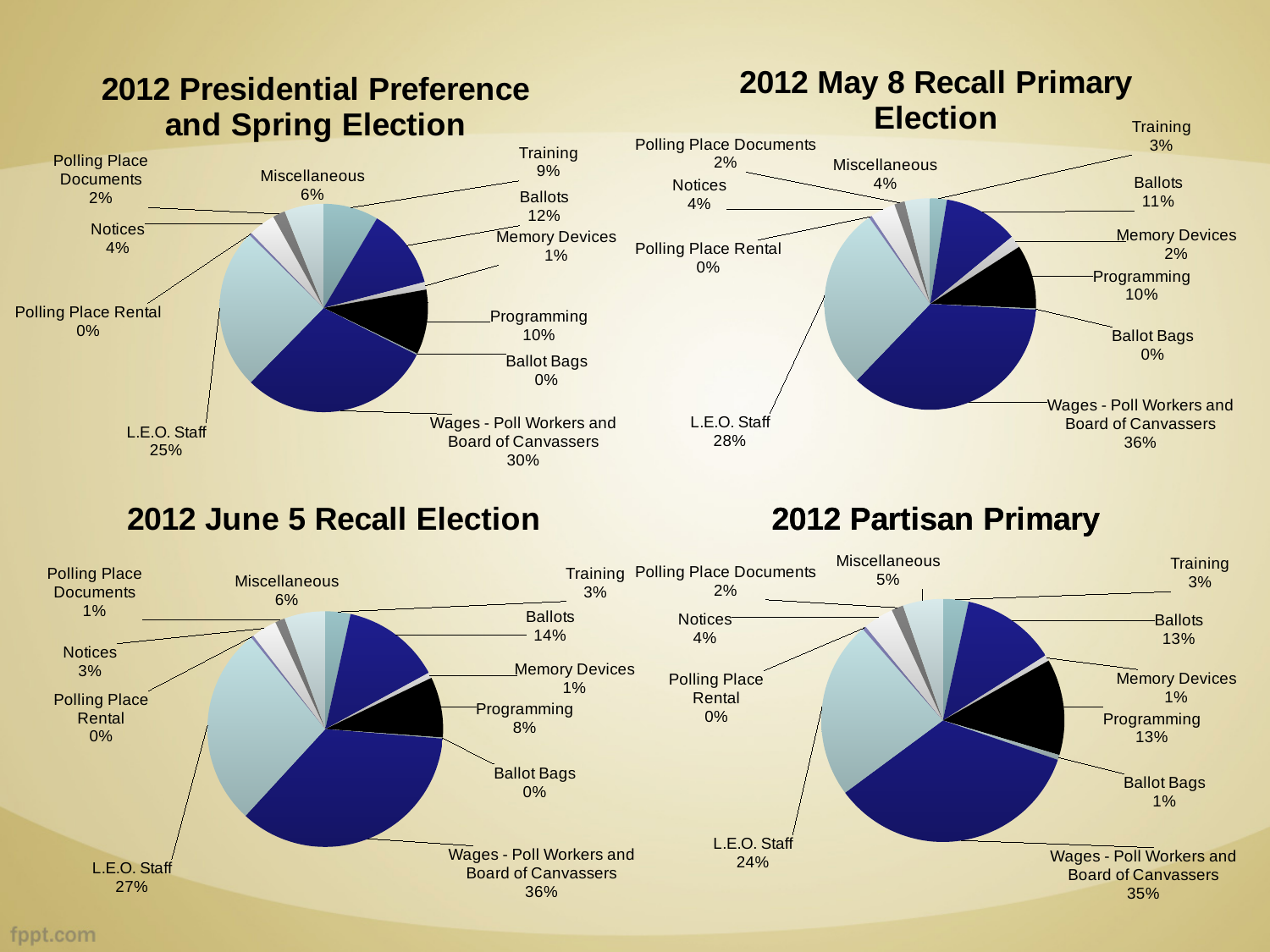
In the 2012 May 8 Recall Primary Election chart, what is the value for L.E.O. Staff? 28% In the 2012 May 8 Recall Primary Election chart, which category has the largest share? Wages - Poll Workers and Board of Canvassers In the 2012 June 5 Recall Election chart, what is the value for Programming? 8% How many categories are shown in the 2012 Partisan Primary chart? 11 In the 2012 Partisan Primary chart, what is the value for Ballot Bags? 1% How many charts are shown on the slide? 4 In the 2012 June 5 Recall Election chart, what is the difference between Wages - Poll Workers and Board of Canvassers and L.E.O. Staff? 9% In the 2012 Partisan Primary chart, which is larger, Ballots or Miscellaneous? Ballots In the 2012 Presidential Preference and Spring Election chart, what is the value for Ballots? 12% In the 2012 Presidential Preference and Spring Election chart, what share does Wages - Poll Workers and Board of Canvassers have? 30% In the 2012 Presidential Preference and Spring Election chart, what is the value for Training? 9% What type of chart is the 2012 June 5 Recall Election chart? Pie chart